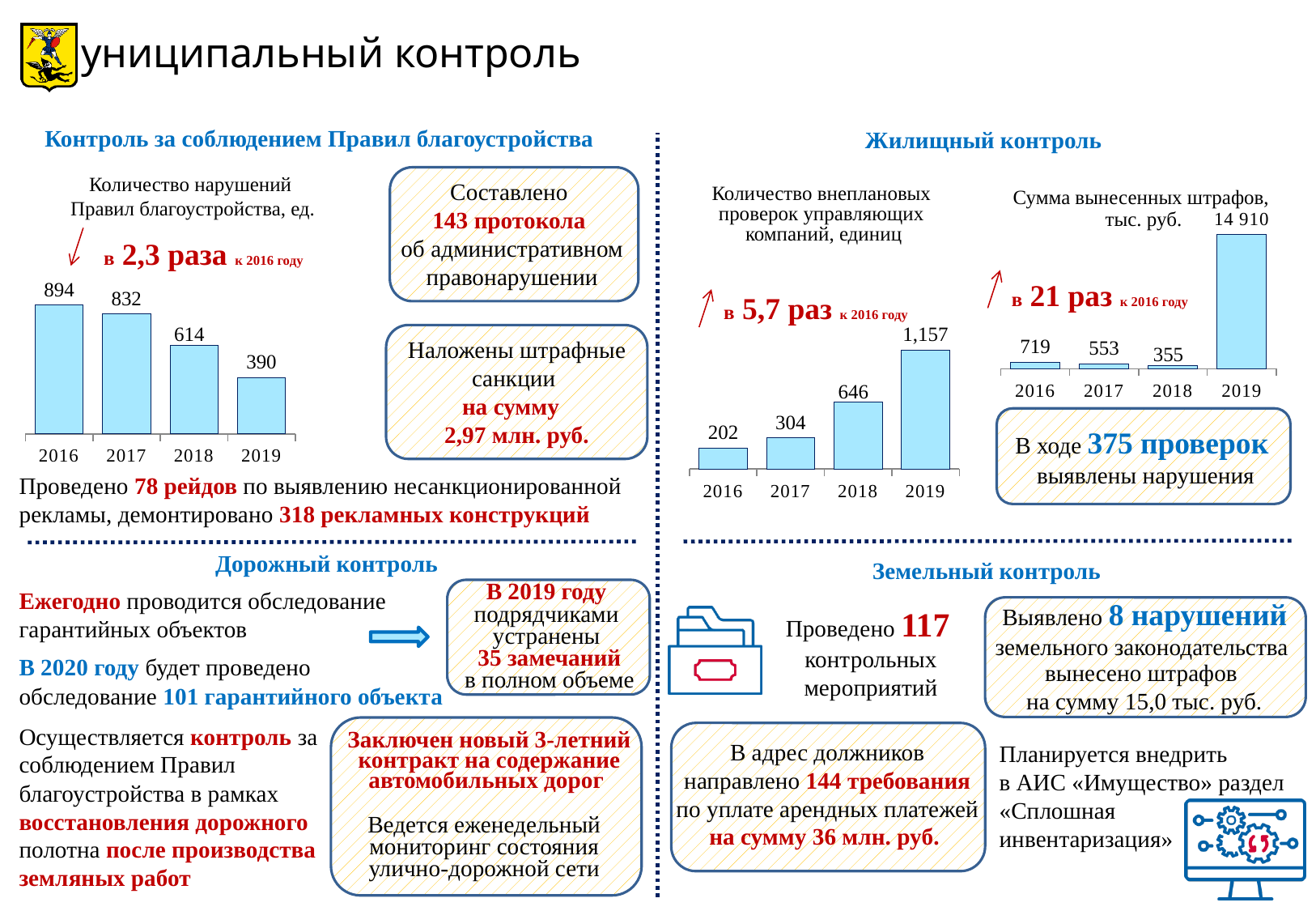
On the chart 'Сумма вынесенных штрафов, тыс. руб.', which is larger, the value for 2016 or the value for 2018? 2016 What type of chart is 'Сумма вынесенных штрафов, тыс. руб.'? bar chart On the chart 'Сумма вынесенных штрафов, тыс. руб.', what is the value for 2019? 14 910 On the chart 'Количество нарушений Правил благоустройства, ед.', which year has the lowest value? 2019 On the chart 'Количество внеплановых проверок управляющих компаний, единиц', what is the difference between the 2018 and 2017 values? 342 On the chart 'Количество внеплановых проверок управляющих компаний, единиц', do the values rise or fall from 2016 to 2019? rise On the chart 'Количество внеплановых проверок управляющих компаний, единиц', what is the value for 2019? 1,157 On the chart 'Количество нарушений Правил благоустройства, ед.', do the values rise or fall from 2016 to 2019? fall On the chart 'Количество внеплановых проверок управляющих компаний, единиц', which year has the highest value? 2019 On the chart 'Количество нарушений Правил благоустройства, ед.', what is the difference between the 2016 and 2019 values? 504 On the chart 'Количество нарушений Правил благоустройства, ед.', what is the value for 2016? 894 On the chart 'Сумма вынесенных штрафов, тыс. руб.', how many years are shown? 4